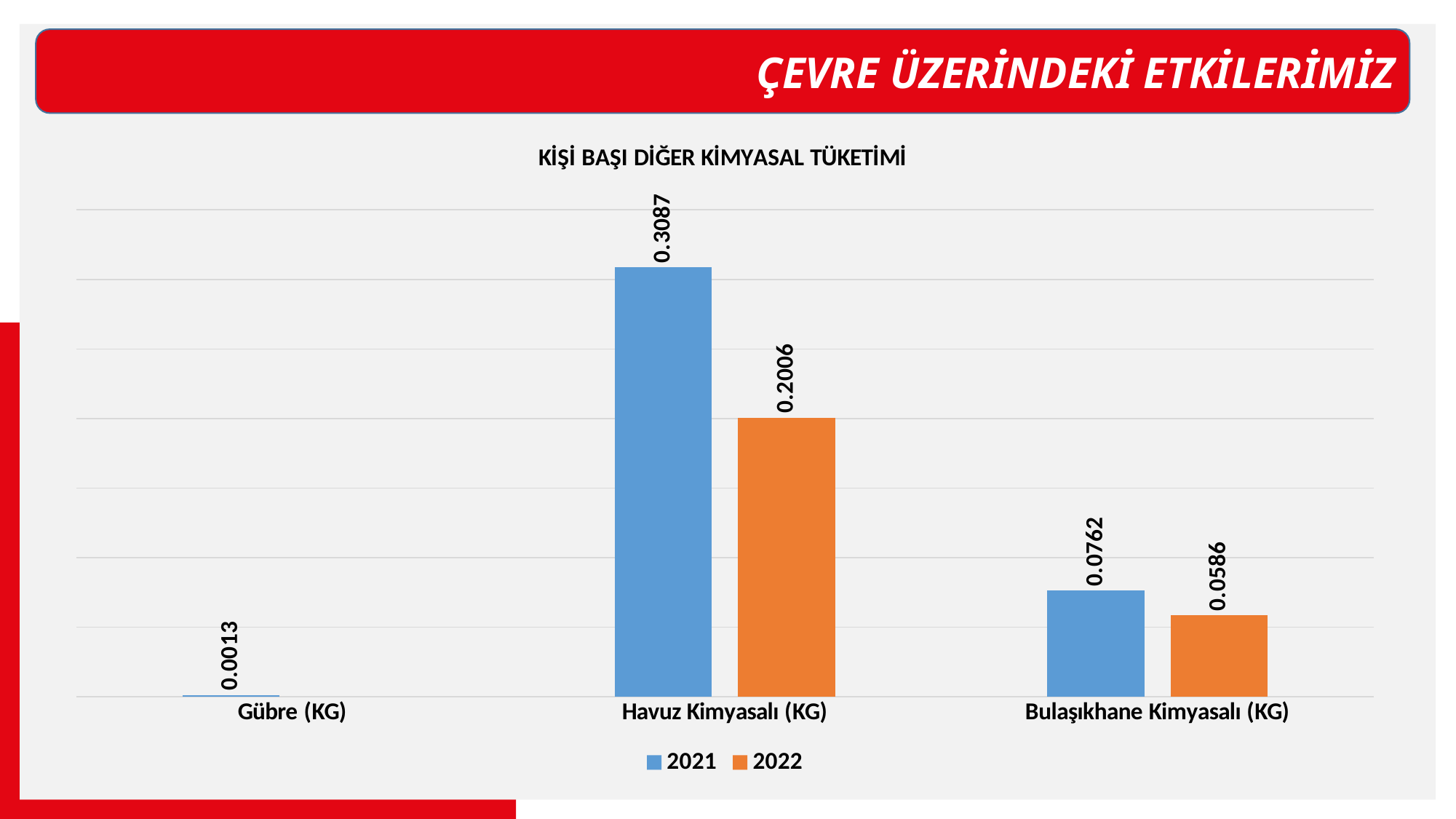
How many series does the legend list? 2 Which category has the highest 2021 value? Havuz Kimyasalı (KG) Which is larger for Bulaşıkhane Kimyasalı (KG): the 2021 value or the 2022 value? 2021 What is the title of the chart? KİŞİ BAŞI DİĞER KİMYASAL TÜKETİMİ What type of chart is shown on the slide? Bar chart What is the 2021 value for Bulaşıkhane Kimyasalı (KG)? 0.0762 What is the 2021 value for Gübre (KG)? 0.0013 How many categories are shown on the x axis? 3 What is the 2022 value for Bulaşıkhane Kimyasalı (KG)? 0.0586 What is the 2022 value for Havuz Kimyasalı (KG)? 0.2006 What is the difference between the 2021 and 2022 values for Havuz Kimyasalı (KG)? 0.1081 What is the 2021 value for Havuz Kimyasalı (KG)? 0.3087